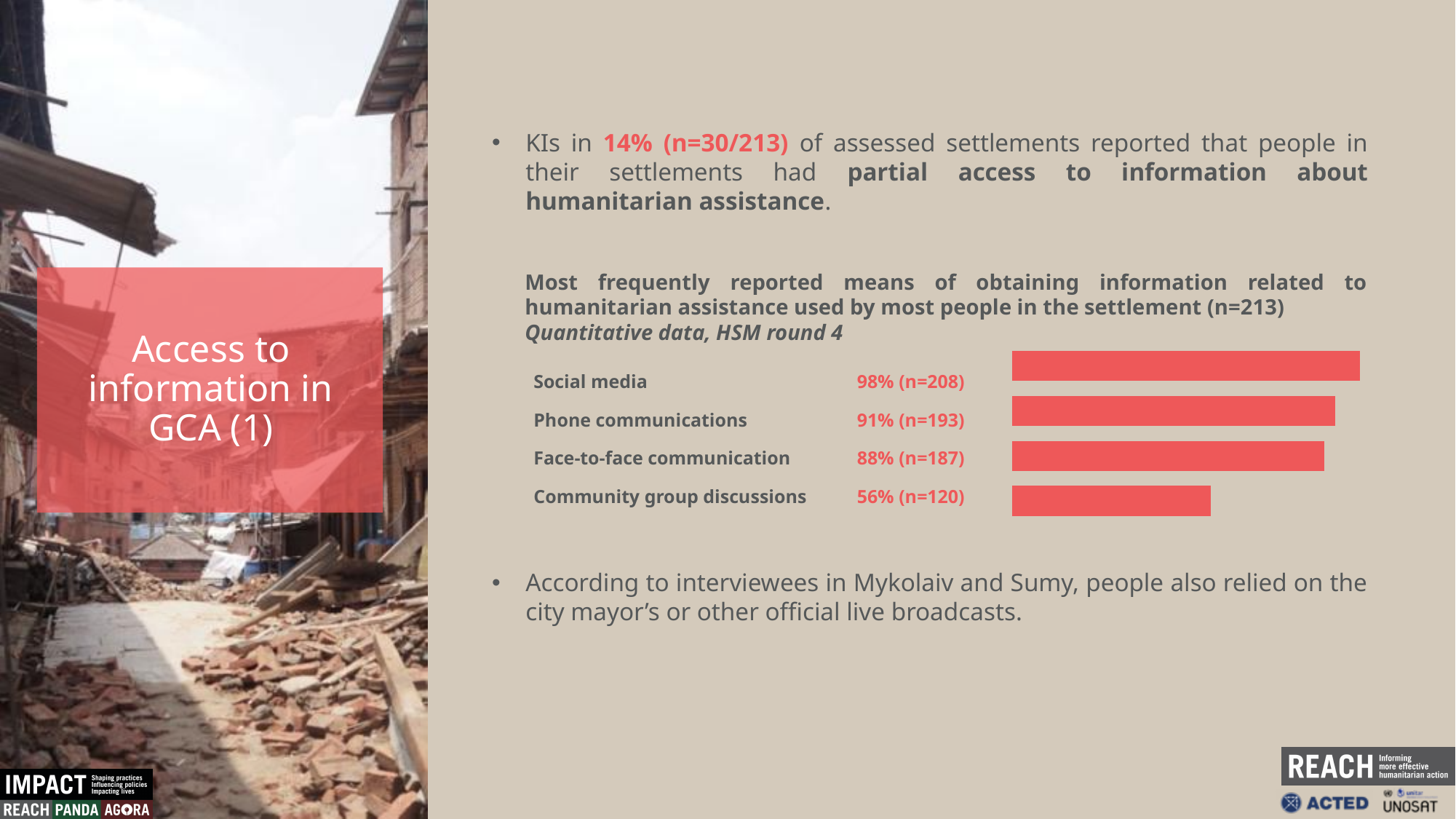
What percentage is shown for Social media as a means of obtaining information about humanitarian assistance? 98% What is the difference in percentage points between Phone communications and Face-to-face communication? 3 Which means of obtaining information has the lowest percentage? Community group discussions How many means of obtaining information are shown in the chart? 4 What is the difference in percentage points between Social media and Community group discussions? 42 What is the n value shown for Community group discussions? n=120 What percentage is shown for Face-to-face communication? 88% What colour are the bars in the chart? Red What percentage is shown for Phone communications? 91% Which has a higher percentage, Phone communications or Face-to-face communication? Phone communications Which means of obtaining information has the highest percentage? Social media What kind of chart is used to show the means of obtaining information? Bar chart